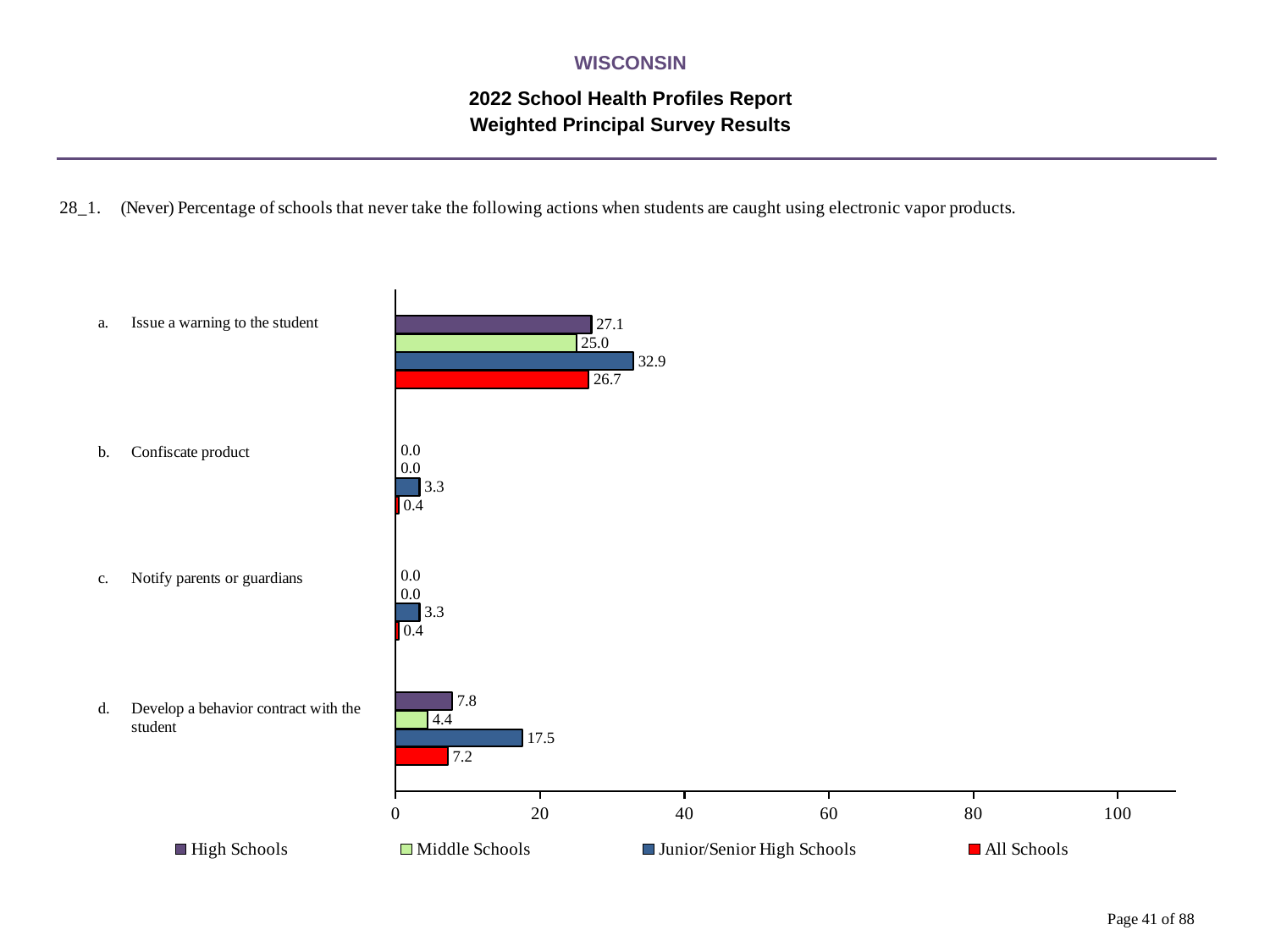
What is the value for Junior/Senior High Schools for 'Issue a warning to the student'? 32.9 What is the value for All Schools for 'Develop a behavior contract with the student'? 7.2 How many series does the legend list? 4 Which series has the highest value for 'Develop a behavior contract with the student'? Junior/Senior High Schools Which is larger for 'Develop a behavior contract with the student': the High Schools value or the Middle Schools value? High Schools How many action categories are shown on the chart? 4 Which series is shown in red in the legend? All Schools What is the difference between the High Schools and Middle Schools values for 'Issue a warning to the student'? 2.1 What kind of chart is shown on the slide? bar chart Is the Junior/Senior High Schools value for 'Issue a warning to the student' greater or less than 20? greater Which series has the lowest value for 'Issue a warning to the student'? Middle Schools What is the value for Middle Schools for 'Confiscate product'? 0.0